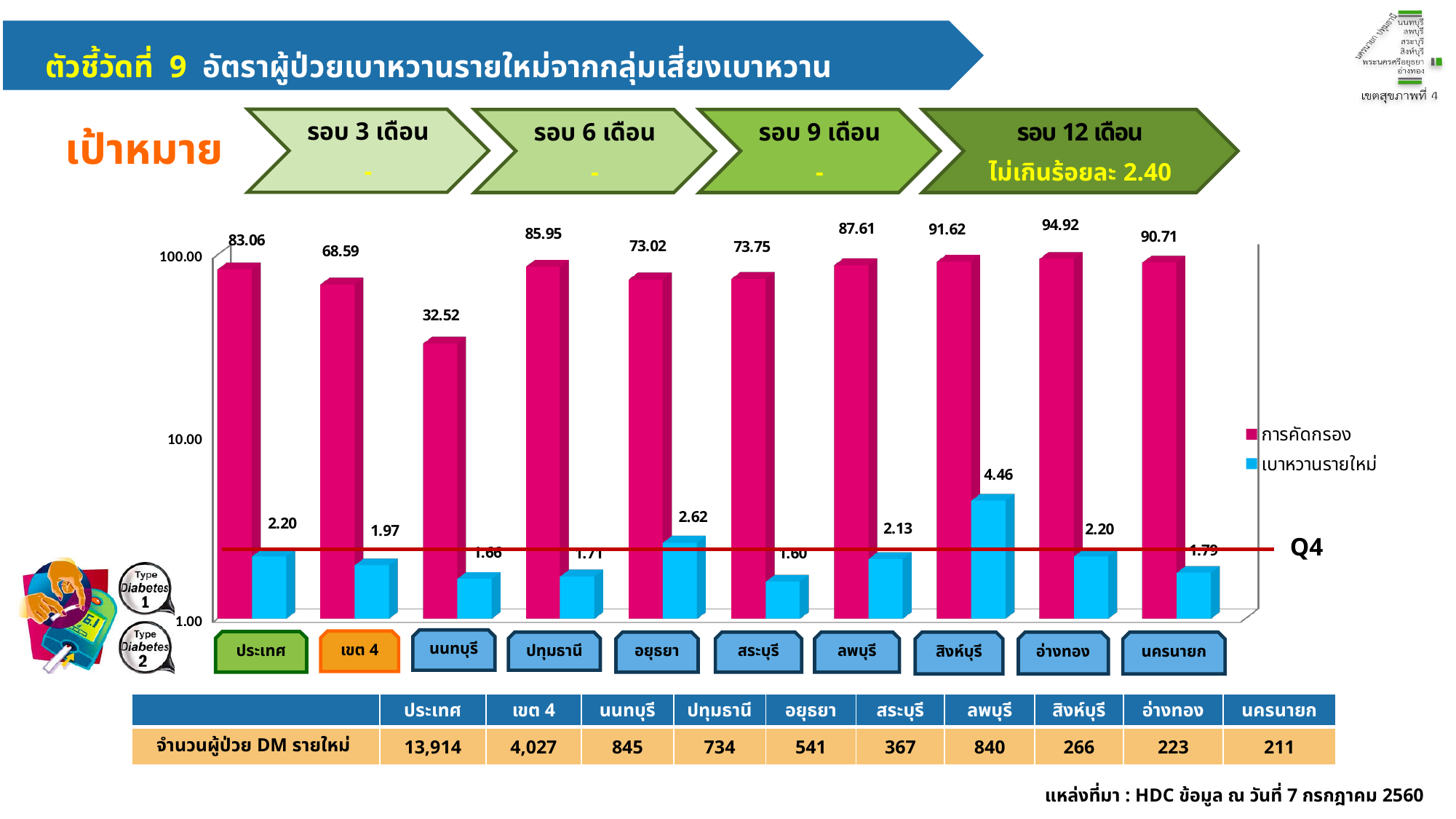
What is the การคัดกรอง value for สิงห์บุรี? 91.62 Which category has the lowest การคัดกรอง value? นนทบุรี Which category has the highest การคัดกรอง value? อ่างทอง What kind of chart is shown on the slide? Bar chart What is the เบาหวานรายใหม่ value for อยุธยา? 2.62 How many series does the chart legend list? 2 How many categories are shown on the x axis of the chart? 10 What is the difference between the การคัดกรอง values for อ่างทอง and เขต 4? 26.33 What is the การคัดกรอง value for นนทบุรี? 32.52 Which is larger, the เบาหวานรายใหม่ value for ลพบุรี or for นครนายก? ลพบุรี Which category has the highest เบาหวานรายใหม่ value? สิงห์บุรี Which category has the lowest เบาหวานรายใหม่ value? สระบุรี